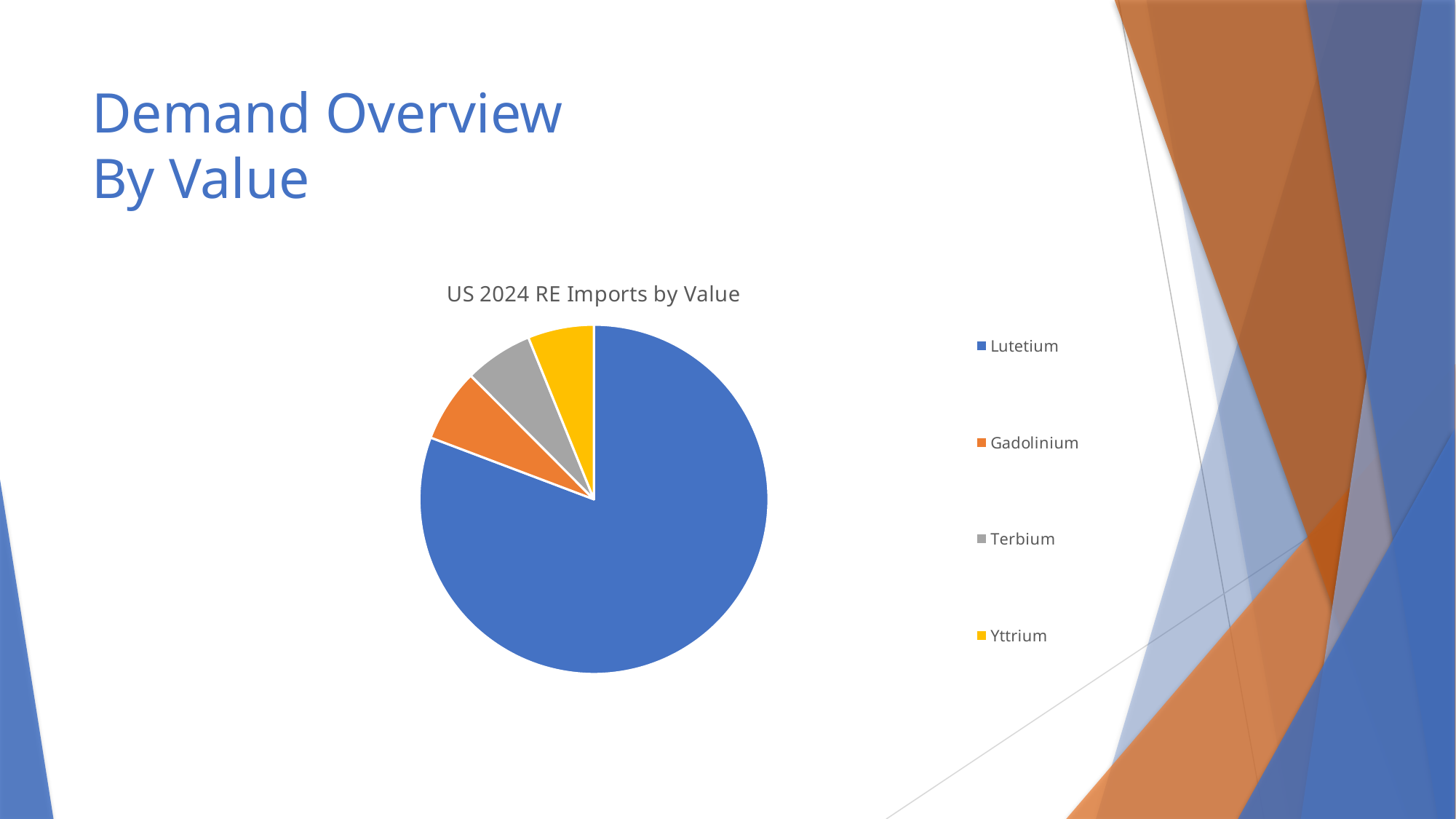
Which category is shown in orange in the pie chart? Gadolinium Which category has the largest slice of the pie? Lutetium What is the title of the chart? US 2024 RE Imports by Value Which is larger, the slice for Lutetium or the slice for Gadolinium? Lutetium Which is larger, the slice for Terbium or the slice for Lutetium? Lutetium How many categories does the pie chart show? 4 What kind of chart is shown on the slide? pie chart Does Lutetium account for more or less than half of the pie? more